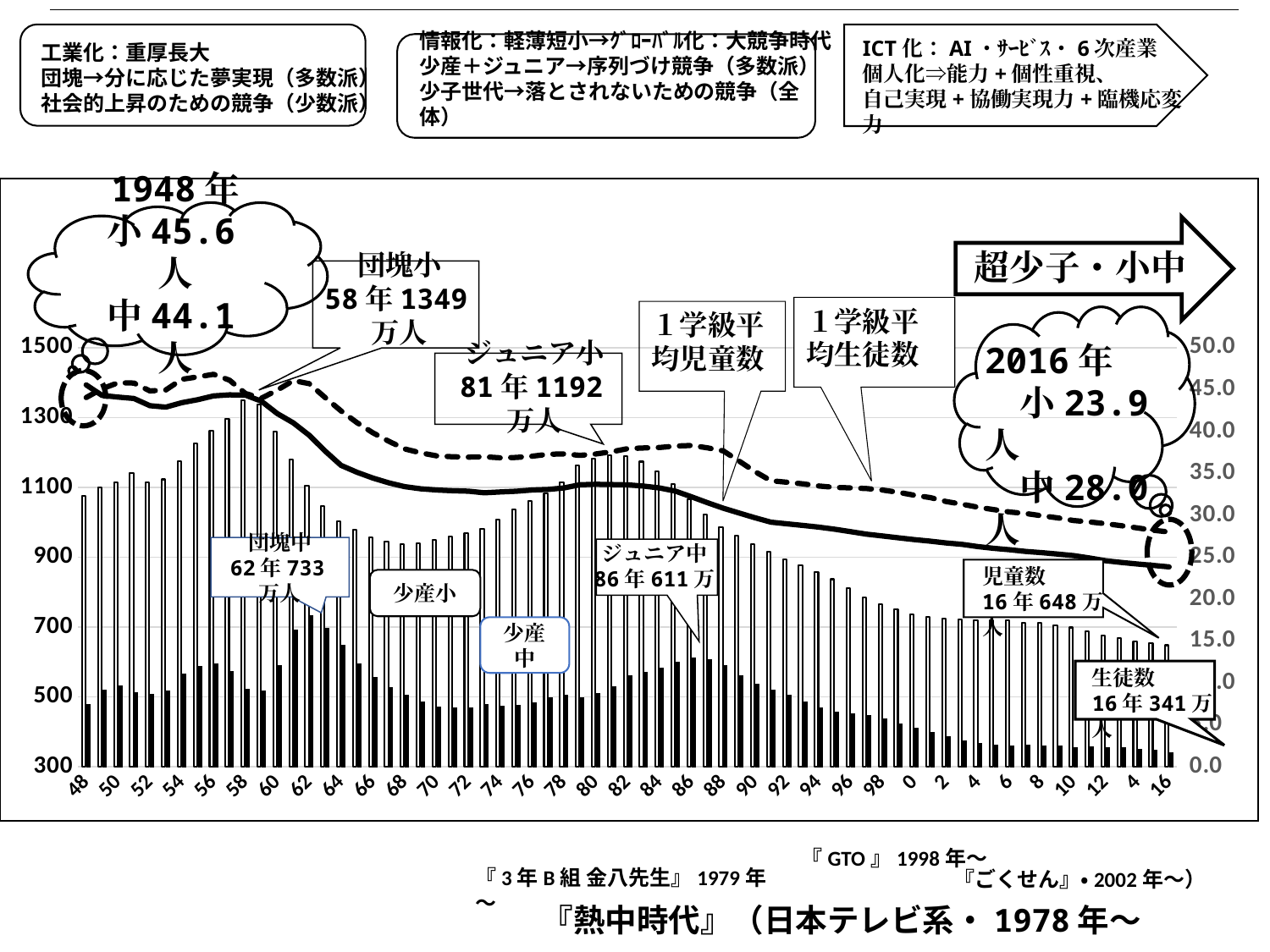
According to the callout, how many elementary school pupils (団塊小) were there in 1958? 1349万人 What was the average elementary class size (小) in 1948 according to the cloud callout? 45.6人 What kind of chart is shown on the slide? Combined bar and line chart What is the difference between the elementary pupil count in 1958 (1349万人) and in 1981 (1192万人)? 157万人 What is the 生徒数 (junior high student count) shown for 2016? 341万 Do the average class size lines (1学級平均児童数 and 1学級平均生徒数) rise or fall overall from 1948 to 2016? fall According to the callout, how many junior high school students (ジュニア中) were there in 1986? 611万 Which is larger: the average elementary class size in 1948 or in 2016? 1948 What was the average junior high class size (中) in 2016 according to the cloud callout? 28.0人 According to the callout, how many junior high school students (団塊中) were there in 1962? 733万人 What is the 児童数 (elementary pupil count) shown for 2016? 648万 According to the callout, how many elementary school pupils (ジュニア小) were there in 1981? 1192万人